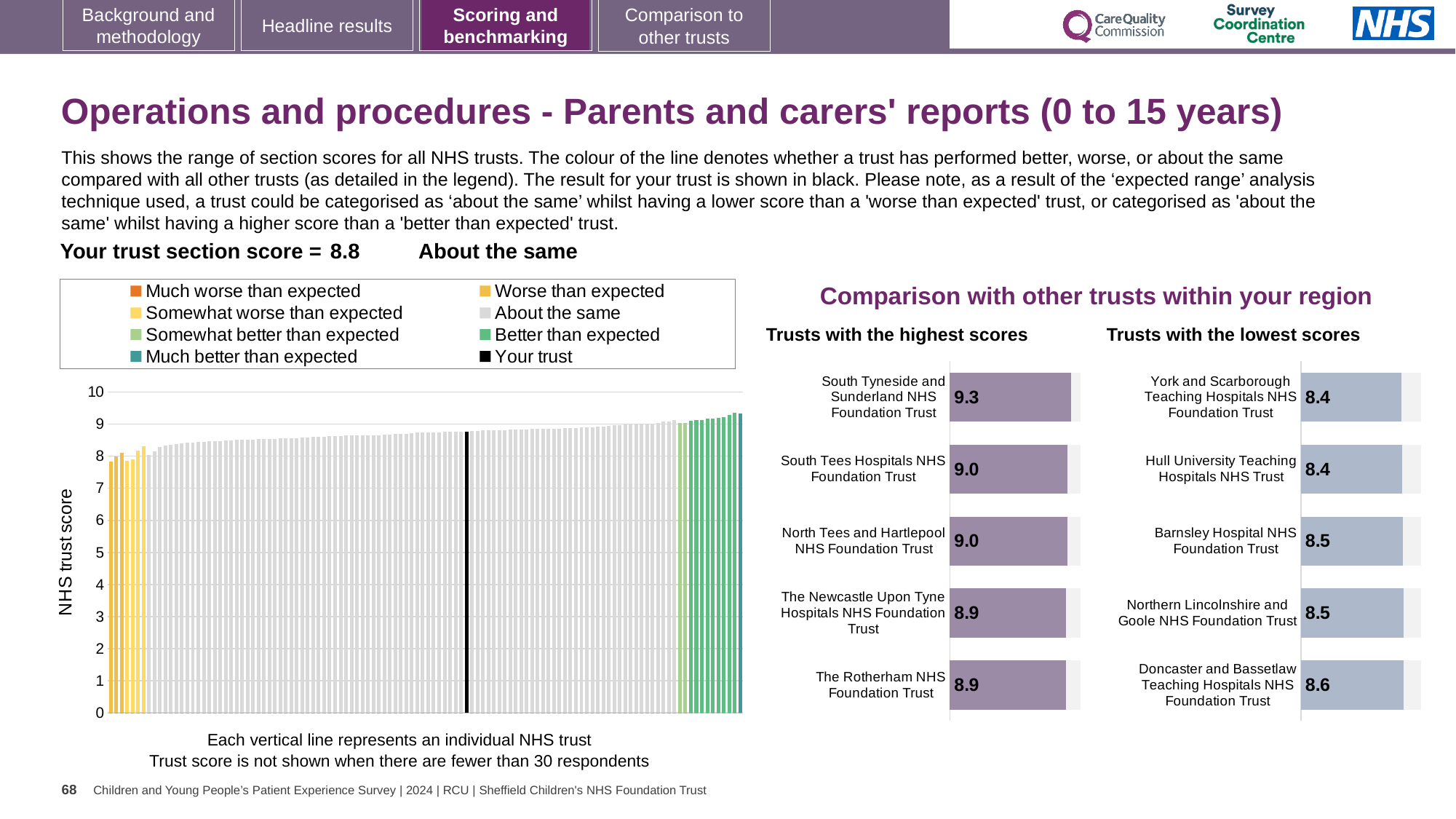
How many entries does the legend above the large chart on the left list? 8 According to the slide, what is your trust's section score for Operations and procedures? 8.8 In the 'Trusts with the lowest scores' chart, what is the score for Doncaster and Bassetlaw Teaching Hospitals NHS Foundation Trust? 8.6 In the large chart on the left, is the value of the black bar (your trust) greater or less than 8? greater What kind of chart is the large chart on the left showing NHS trust scores? bar chart In the 'Trusts with the highest scores' chart, what is the difference between the scores of South Tyneside and Sunderland NHS Foundation Trust and The Rotherham NHS Foundation Trust? 0.4 In the 'Trusts with the highest scores' chart, what is the score for The Rotherham NHS Foundation Trust? 8.9 In the large chart on the left, what is the label on the vertical axis? NHS trust score In the 'Trusts with the lowest scores' chart, which trust has the highest score? Doncaster and Bassetlaw Teaching Hospitals NHS Foundation Trust In the 'Trusts with the lowest scores' chart, which has the larger score: Barnsley Hospital NHS Foundation Trust or York and Scarborough Teaching Hospitals NHS Foundation Trust? Barnsley Hospital NHS Foundation Trust In the 'Trusts with the highest scores' chart, how many trusts are shown? 5 In the 'Trusts with the highest scores' chart, which trust has the highest score? South Tyneside and Sunderland NHS Foundation Trust